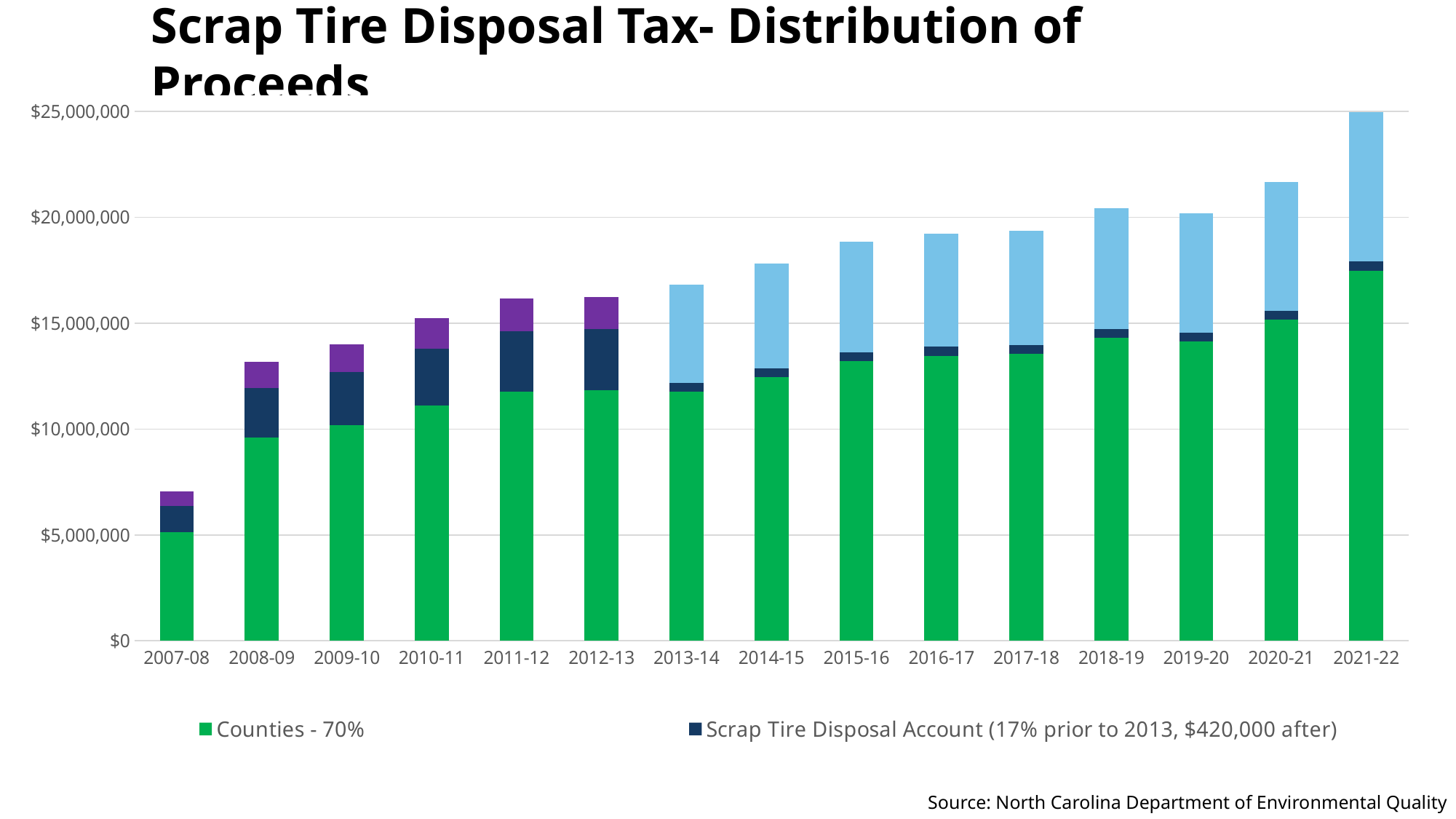
Which total bar is taller, 2020-21 or 2021-22? 2021-22 Which fiscal year has the tallest total bar? 2021-22 How many series does the legend list? 2 Is the Counties segment for 2021-22 greater or less than $15,000,000? greater Is the total bar for 2021-22 greater or less than $20,000,000? greater What is the source cited for the chart? North Carolina Department of Environmental Quality What kind of chart is shown on the slide? Stacked bar chart How many fiscal years are shown along the x axis? 15 Do the total bars generally rise or fall from 2007-08 to 2021-22? rise Is the total bar for 2007-08 greater or less than $10,000,000? less Which fiscal year has the shortest total bar? 2007-08